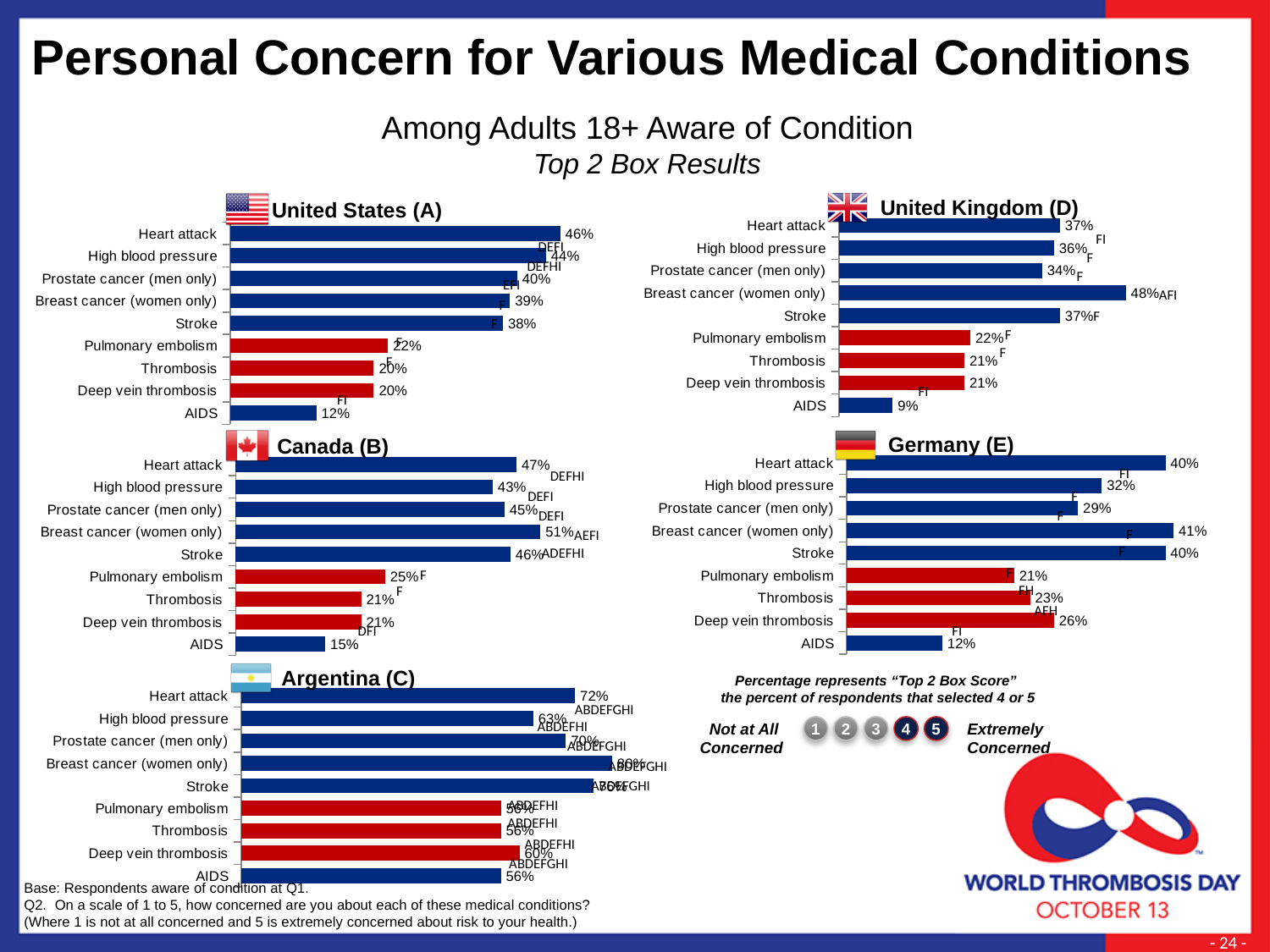
In the United States (A) chart, which condition has the lowest value? AIDS What type of chart is used for the Canada (B) data? Bar chart How many conditions are listed in the United Kingdom (D) chart? 9 In the United States (A) chart, which is larger, Pulmonary embolism or AIDS? Pulmonary embolism In the Canada (B) chart, which condition has the highest value? Breast cancer (women only) In the Argentina (C) chart, what percentage is shown for Heart attack? 72% In the United Kingdom (D) chart, what percentage is shown for AIDS? 9% In the United Kingdom (D) chart, which condition has the highest value? Breast cancer (women only) In the Germany (E) chart, what is the difference between Heart attack and High blood pressure? 8% In the Germany (E) chart, what percentage is shown for Deep vein thrombosis? 26% In the United States (A) chart, what percentage is shown for Heart attack? 46% In the Canada (B) chart, what percentage is shown for Breast cancer (women only)? 51%